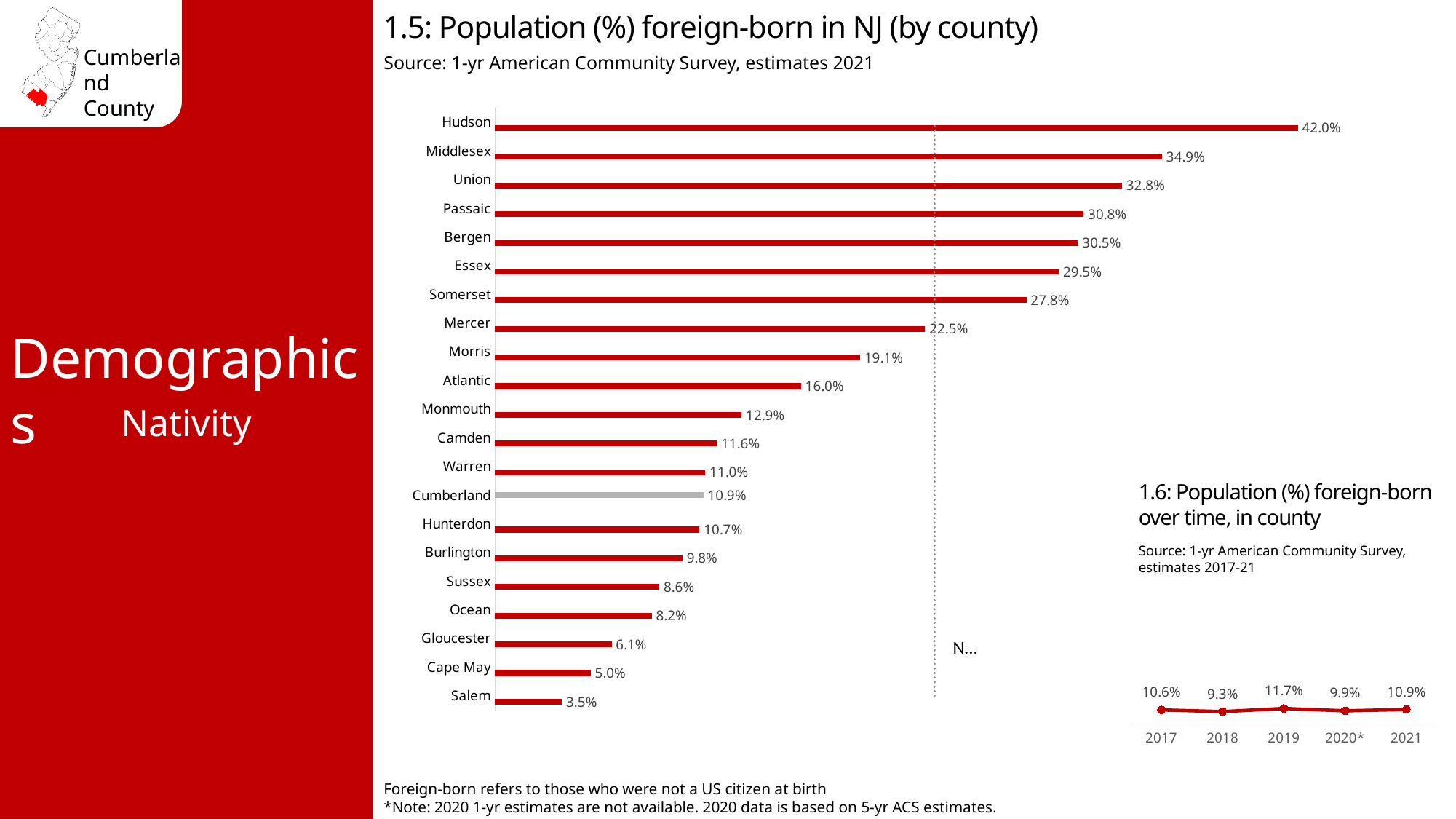
In chart 1.6 (Population (%) foreign-born over time, in county), what is the difference between 2021 and 2017? 0.3% In chart 1.5 (Population (%) foreign-born in NJ by county), which county has the highest value? Hudson In chart 1.6 (Population (%) foreign-born over time, in county), which year has the lowest value? 2018 In chart 1.5 (Population (%) foreign-born in NJ by county), what is the value for Cumberland? 10.9% In chart 1.5 (Population (%) foreign-born in NJ by county), what is the value for Hudson? 42.0% In chart 1.5 (Population (%) foreign-born in NJ by county), which county has the lowest value? Salem In chart 1.6 (Population (%) foreign-born over time, in county), what is the value for 2019? 11.7% In chart 1.5 (Population (%) foreign-born in NJ by county), how many counties are plotted? 21 In chart 1.5 (Population (%) foreign-born in NJ by county), which is larger, Atlantic or Monmouth? Atlantic What kind of chart is chart 1.5 (Population (%) foreign-born in NJ by county)? Bar chart In chart 1.5 (Population (%) foreign-born in NJ by county), what is the difference between Middlesex and Union? 2.1% In chart 1.5 (Population (%) foreign-born in NJ by county), which county's bar is shown in grey instead of red? Cumberland